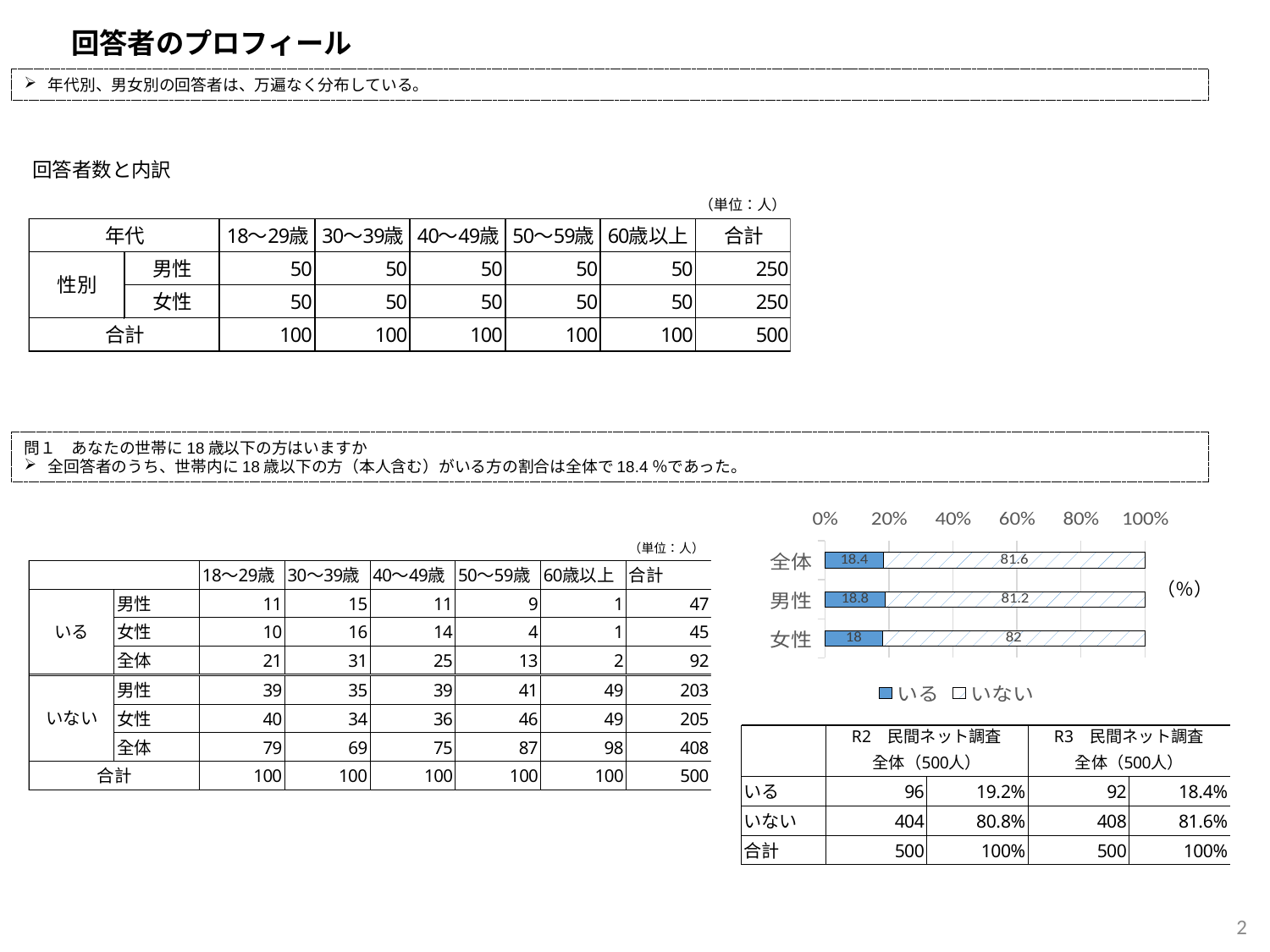
In the bar chart, what is the value of いる for 全体? 18.4 How many categories are shown on the bar chart's vertical axis? 3 In the bar chart, what is the value of いない for 男性? 81.2 In the bar chart, what is the value of いない for 女性? 82 In the bar chart, is the いない value for 全体 larger or smaller than the いる value for 全体? larger In the bar chart, which category has the lowest value for いる? 女性 In the bar chart, which category has the highest value for いる? 男性 What are the two legend entries of the bar chart? いる, いない What kind of chart is shown on the slide? stacked bar chart In the bar chart, what is the value of いる for 女性? 18 How many series does the bar chart's legend list? 2 In the bar chart, what is the difference between the いる values for 男性 and 女性? 0.8